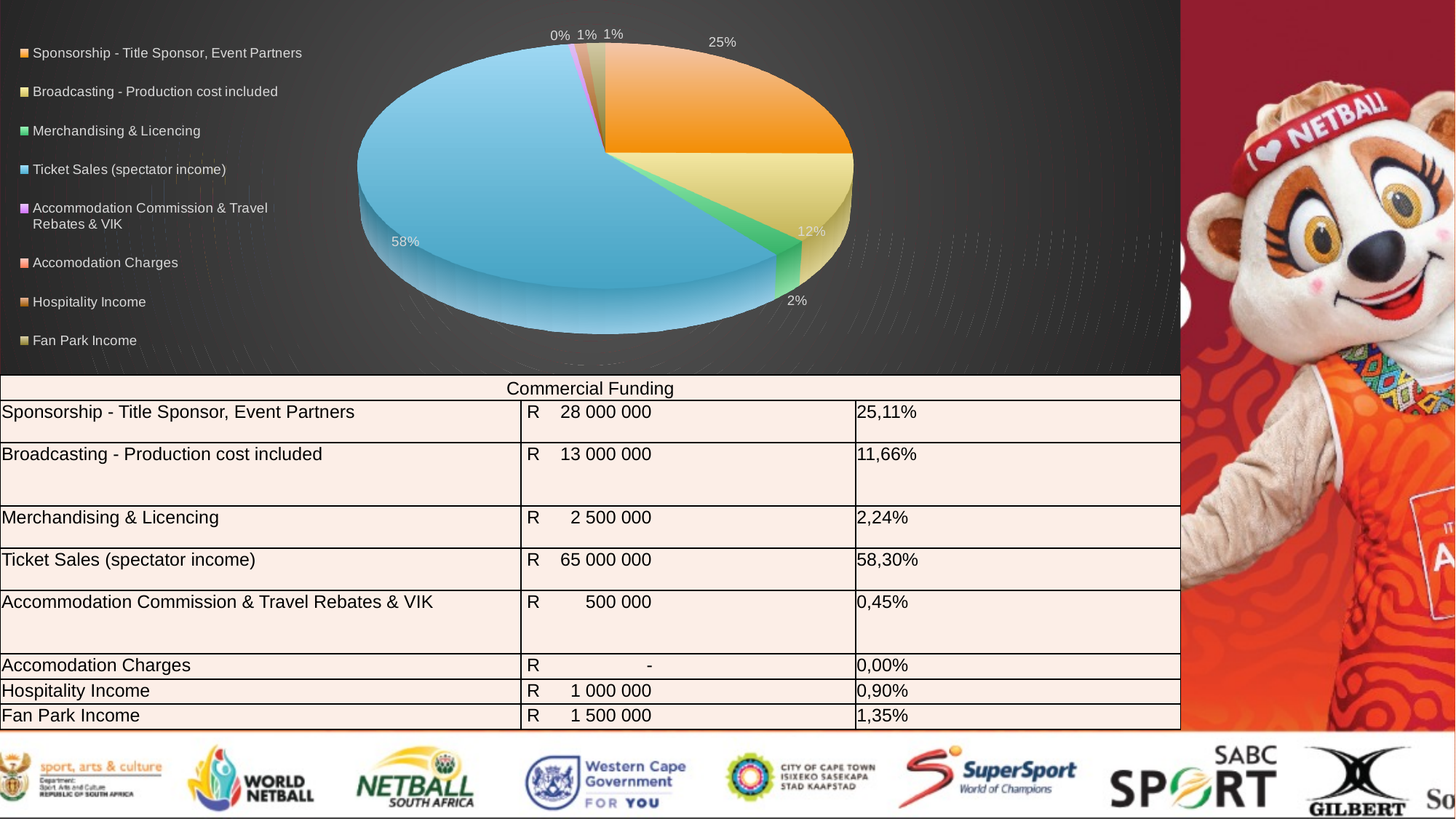
What share of the pie does Merchandising & Licencing represent? 2% What type of chart is shown on the slide? pie chart What is the difference in percentage points between the Ticket Sales (spectator income) slice and the Sponsorship - Title Sponsor, Event Partners slice? 33% What colour is the Ticket Sales (spectator income) slice in the pie chart? light blue What share of the pie does Hospitality Income represent? 1% Which category has the largest slice of the pie? Ticket Sales (spectator income) What share of the pie does Fan Park Income represent? 1% Which is larger, the slice for Sponsorship - Title Sponsor, Event Partners or the slice for Broadcasting - Production cost included? Sponsorship - Title Sponsor, Event Partners How many categories does the legend of the pie chart list? 8